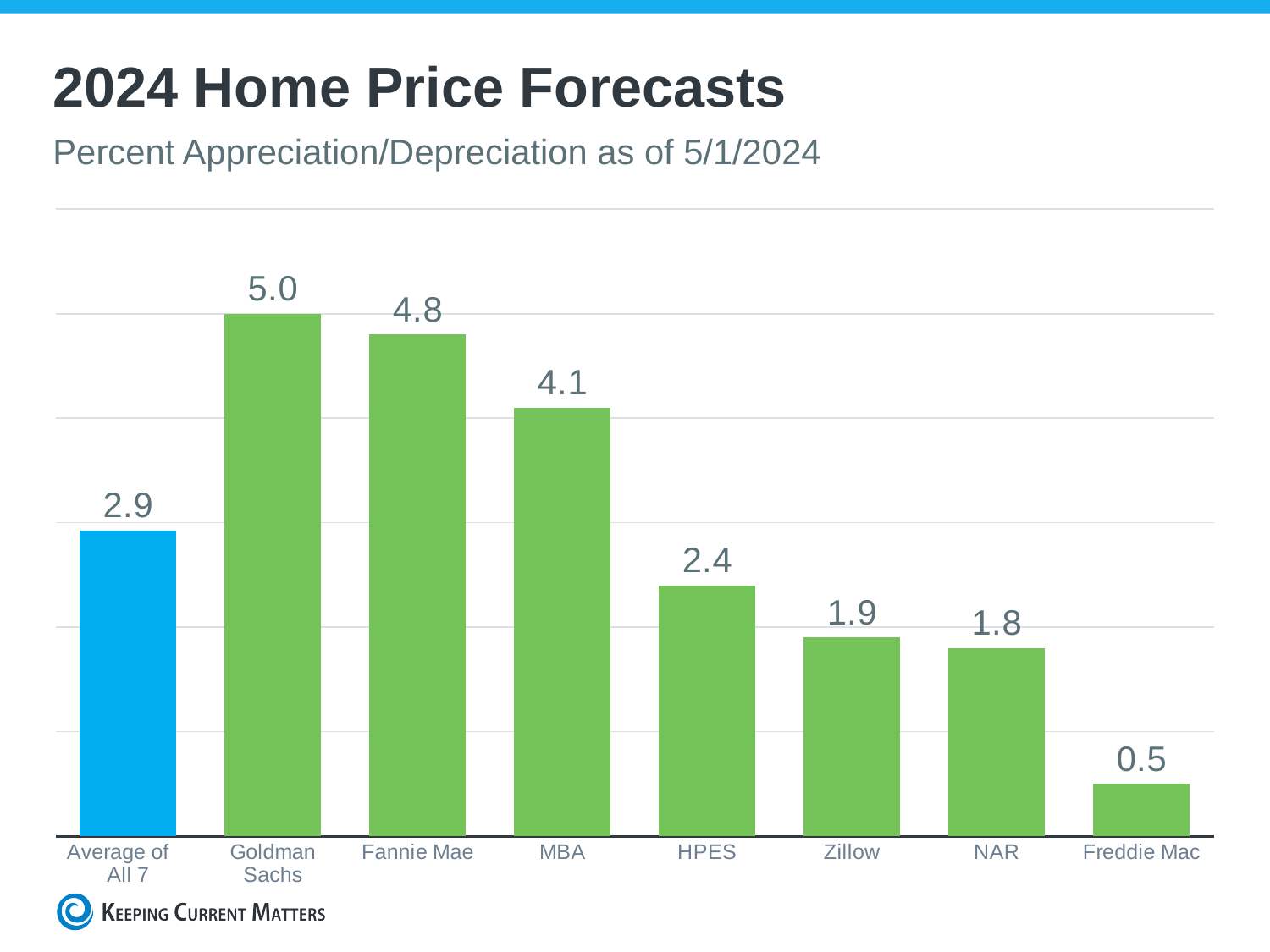
Which is larger, the HPES forecast or the NAR forecast? HPES What kind of chart is shown on the slide? Bar chart What is the difference between the Fannie Mae and MBA forecasts? 0.7 What is the difference between the Goldman Sachs forecast and the Average of All 7? 2.1 Which forecaster has the lowest value? Freddie Mac What is the forecast value for Freddie Mac? 0.5 Which bar is shown in a different colour (blue) from the others? Average of All 7 How many bars are shown in the chart? 8 What is the forecast value for Goldman Sachs? 5.0 What is the value shown for Average of All 7? 2.9 What is the forecast value for Zillow? 1.9 Which forecaster has the highest value? Goldman Sachs